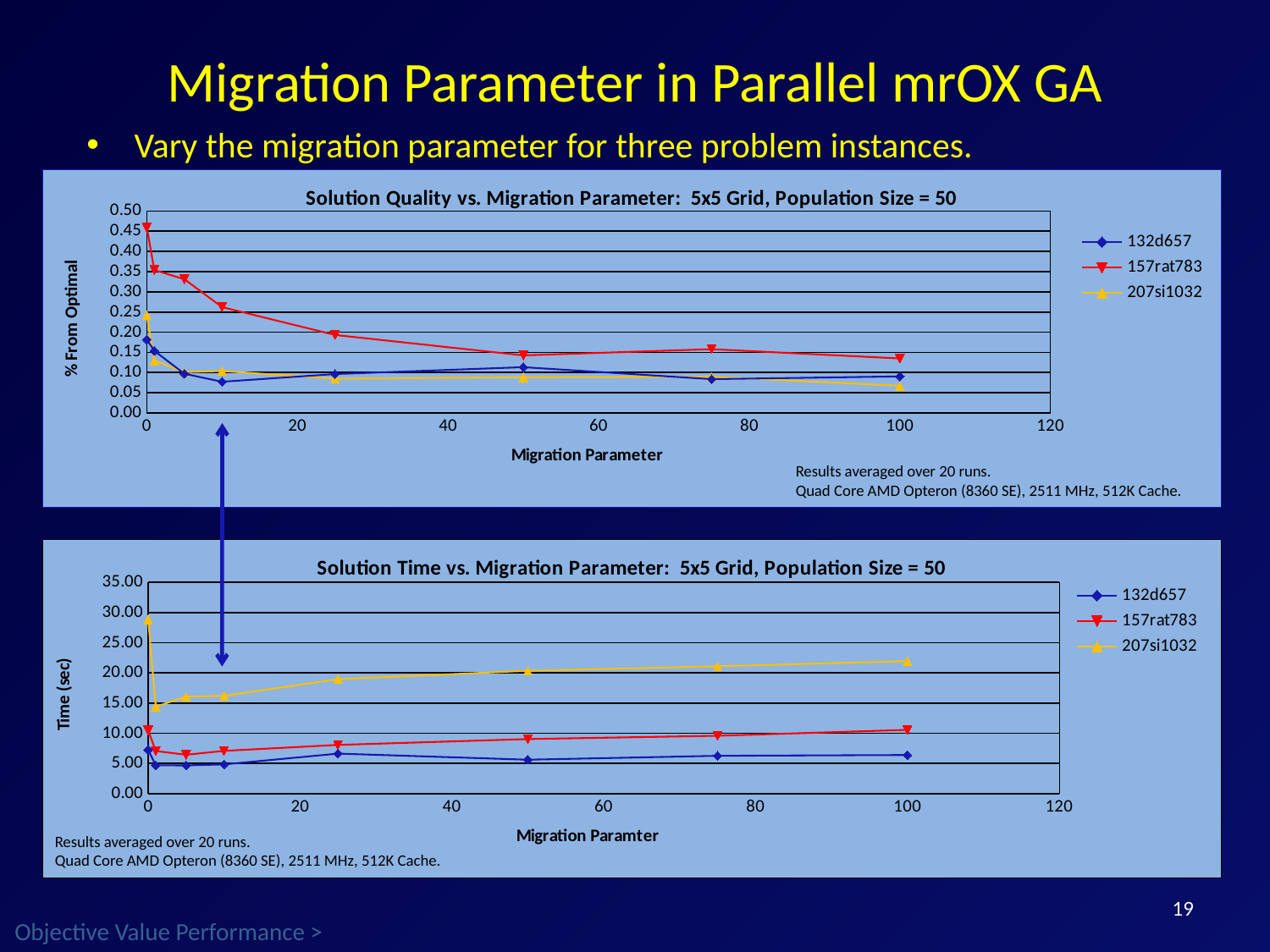
In the top chart, 'Solution Quality vs. Migration Parameter', which series has the highest % from optimal at migration parameter 0? 157rat783 What is the y-axis label of the bottom chart, 'Solution Time vs. Migration Parameter'? Time (sec) What kind of chart is the bottom chart, 'Solution Time vs. Migration Parameter'? line chart In the top chart, 'Solution Quality vs. Migration Parameter', does the 157rat783 series generally rise or fall as the migration parameter increases? fall In the bottom chart, 'Solution Time vs. Migration Parameter', how many series does the legend list? 3 What kind of chart is the top chart, 'Solution Quality vs. Migration Parameter'? line chart In the bottom chart, 'Solution Time vs. Migration Parameter', is the value for 207si1032 at migration parameter 0 greater or less than 25.00? greater In the top chart, 'Solution Quality vs. Migration Parameter', how many series does the legend list? 3 In the top chart, 'Solution Quality vs. Migration Parameter', is the value for 157rat783 at migration parameter 100 greater or less than 0.20? less In the bottom chart, 'Solution Time vs. Migration Parameter', which series has the highest time at migration parameter 100? 207si1032 In the top chart, 'Solution Quality vs. Migration Parameter', is the value for 157rat783 at migration parameter 0 greater or less than 0.40? greater In the bottom chart, 'Solution Time vs. Migration Parameter', at migration parameter 100, which series has the larger time: 157rat783 or 132d657? 157rat783